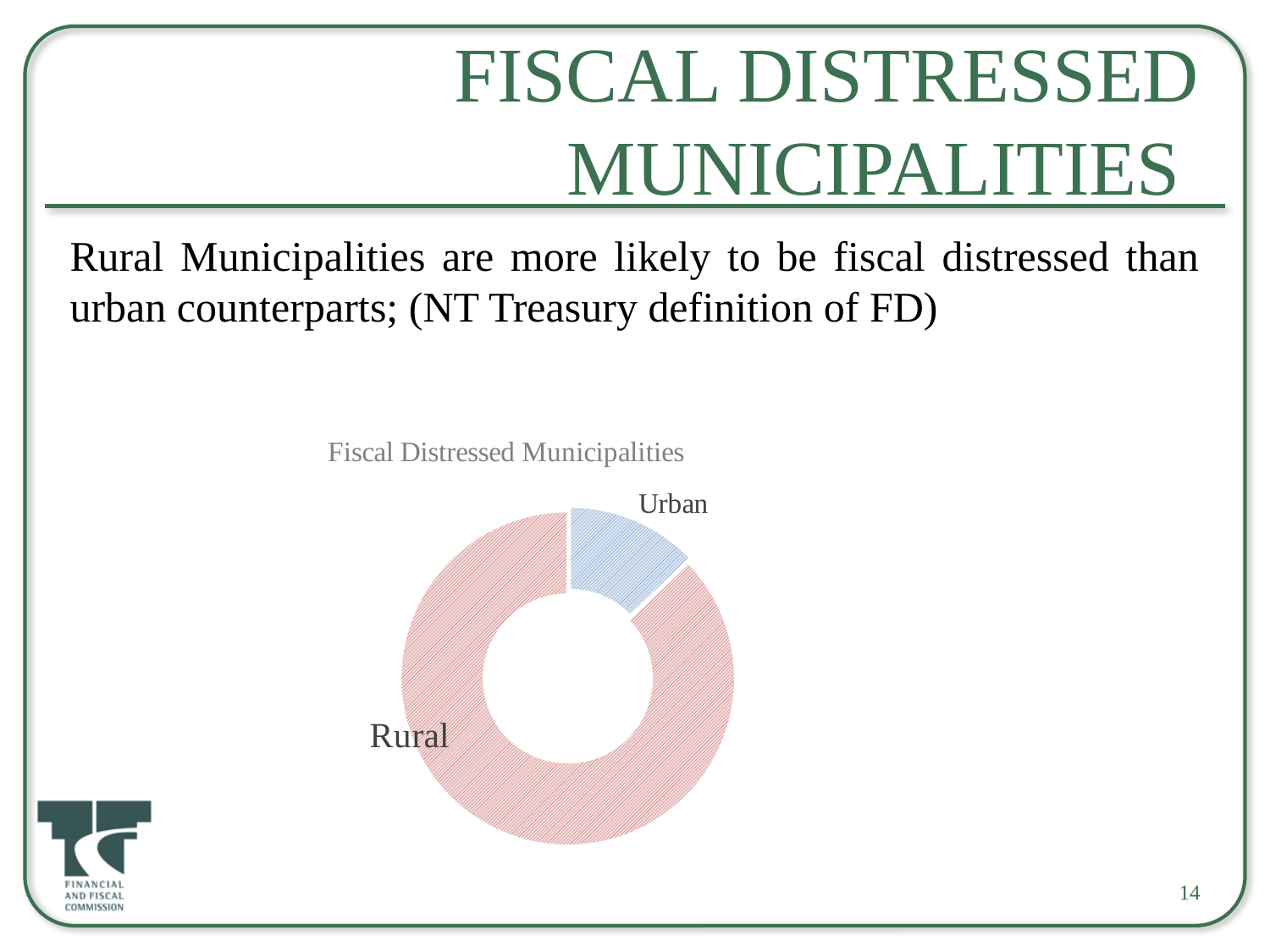
What kind of chart is shown on the slide? Pie chart (doughnut) What is the title of the chart? Fiscal Distressed Municipalities Which is larger, the Rural slice or the Urban slice? Rural How many categories does the chart show? 2 What are the two categories labelled on the chart? Rural and Urban Which category has the largest share of the chart? Rural Which category has the smallest share of the chart? Urban